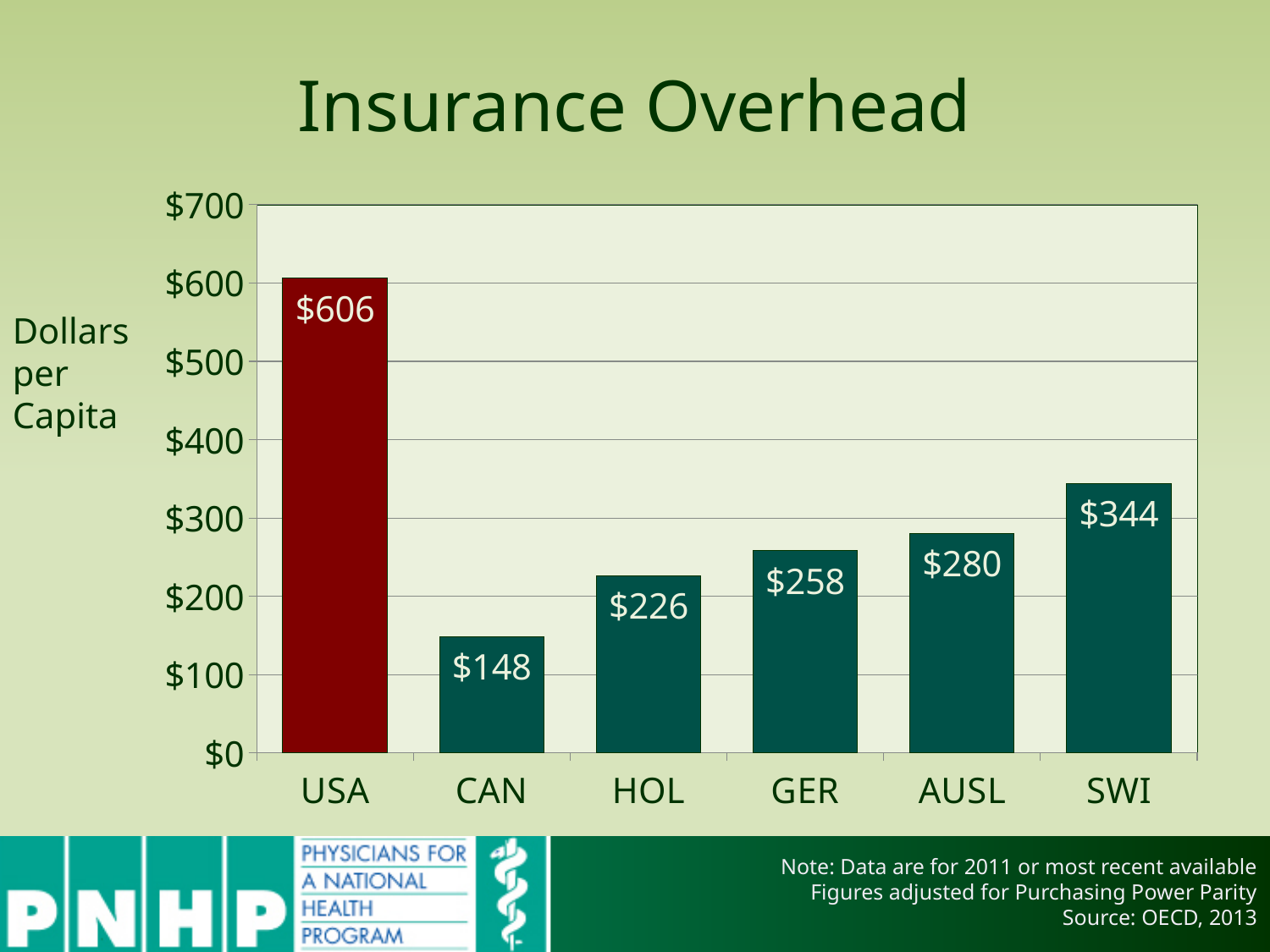
What is the difference between the USA and SWI values? $262 Which country has the lowest insurance overhead per capita? CAN What is the title of the chart? Insurance Overhead What is the difference between the GER and HOL values? $32 How many countries are shown on the chart? 6 Is the value for HOL greater or less than $300? less Which country has the highest insurance overhead per capita? USA What is the insurance overhead value for USA? $606 What is the insurance overhead value for SWI? $344 Which is larger, the value for AUSL or the value for GER? AUSL What is the insurance overhead value for CAN? $148 What kind of chart is shown on the slide? bar chart